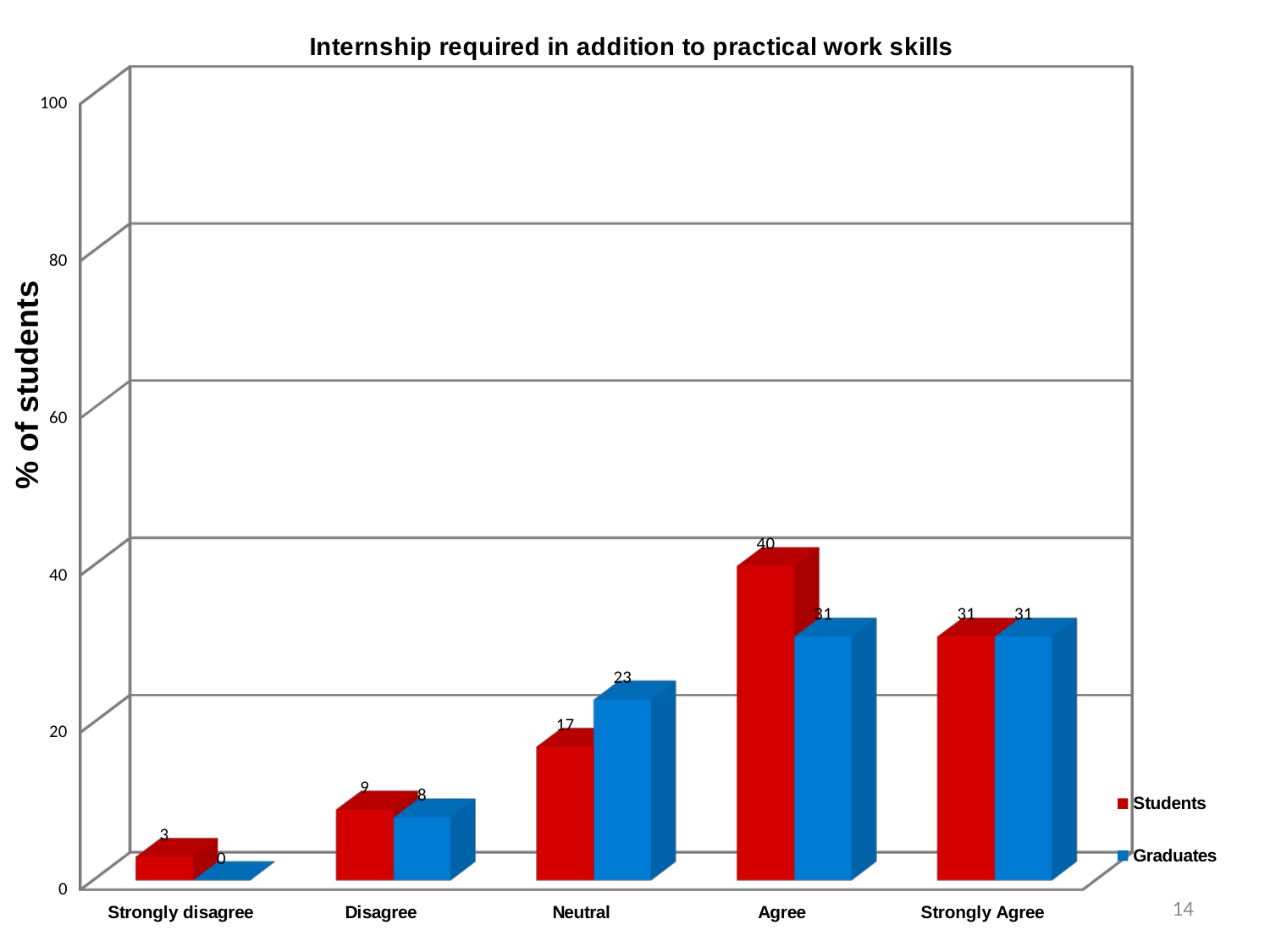
What is the value for Students in the Agree category? 40 Which category has the highest value for Students? Agree Which is larger in the Neutral category, the Students value or the Graduates value? Graduates What is the value for Graduates in the Strongly disagree category? 0 How many series does the legend list? 2 Which category has the lowest value for Graduates? Strongly disagree Is the value for Students in the Agree category greater or less than 20? greater What is the value for Graduates in the Neutral category? 23 How many categories are shown on the x axis? 5 What is the difference between the Students and Graduates values in the Agree category? 9 What kind of chart is shown on the slide? bar chart What is the title of the chart? Internship required in addition to practical work skills